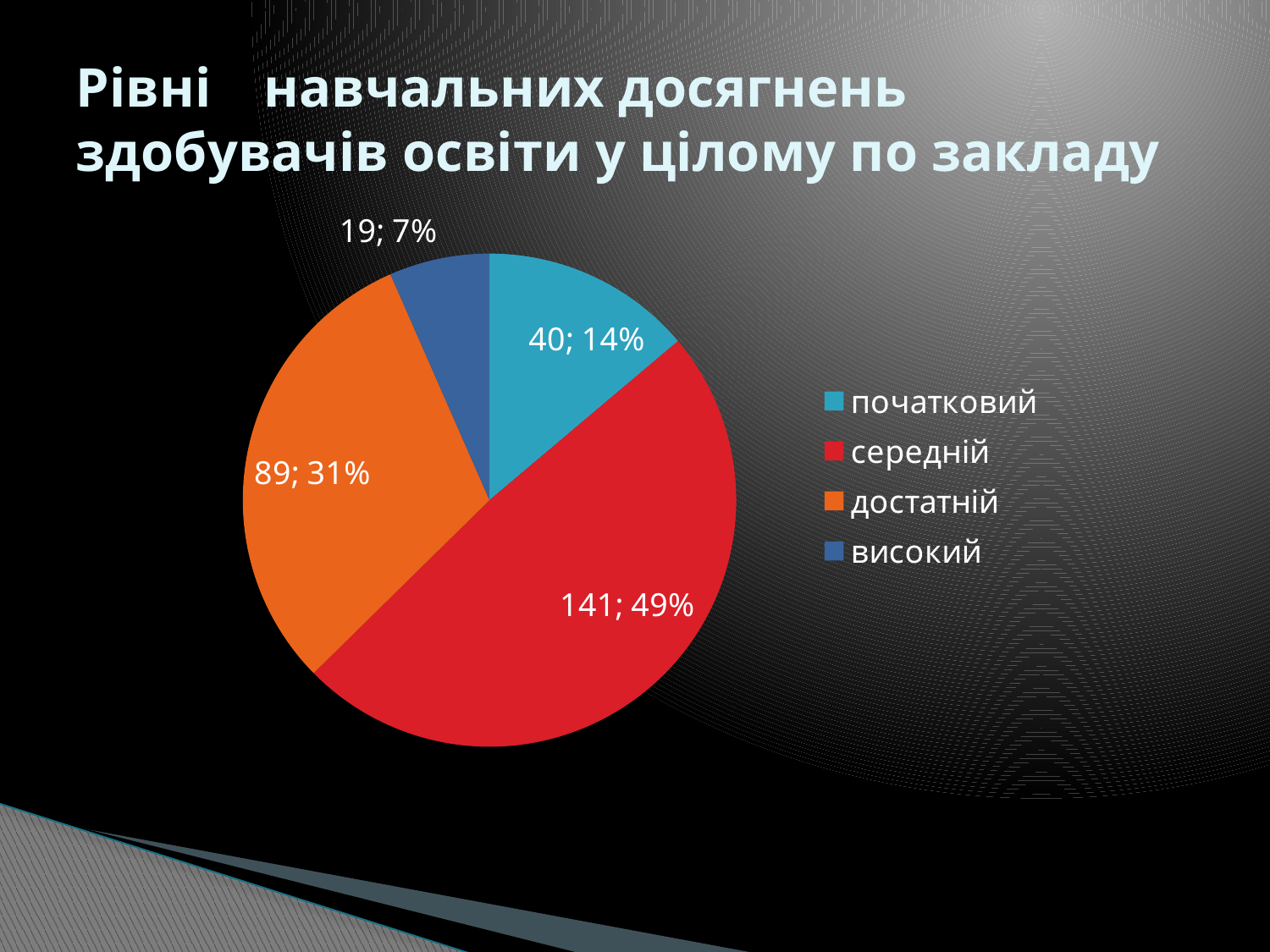
What is the value for високий? 19 What is the value for початковий? 40 What is the value for достатній? 89 Which category has the smallest slice? високий What kind of chart is shown on the slide? pie chart Which category has the largest slice? середній What share of the pie does достатній represent? 31% How many categories does the pie chart have? 4 What is the value for середній? 141 What share of the pie does початковий represent? 14% Which is larger, the value for початковий or the value for високий? початковий What is the difference between the values for середній and достатній? 52